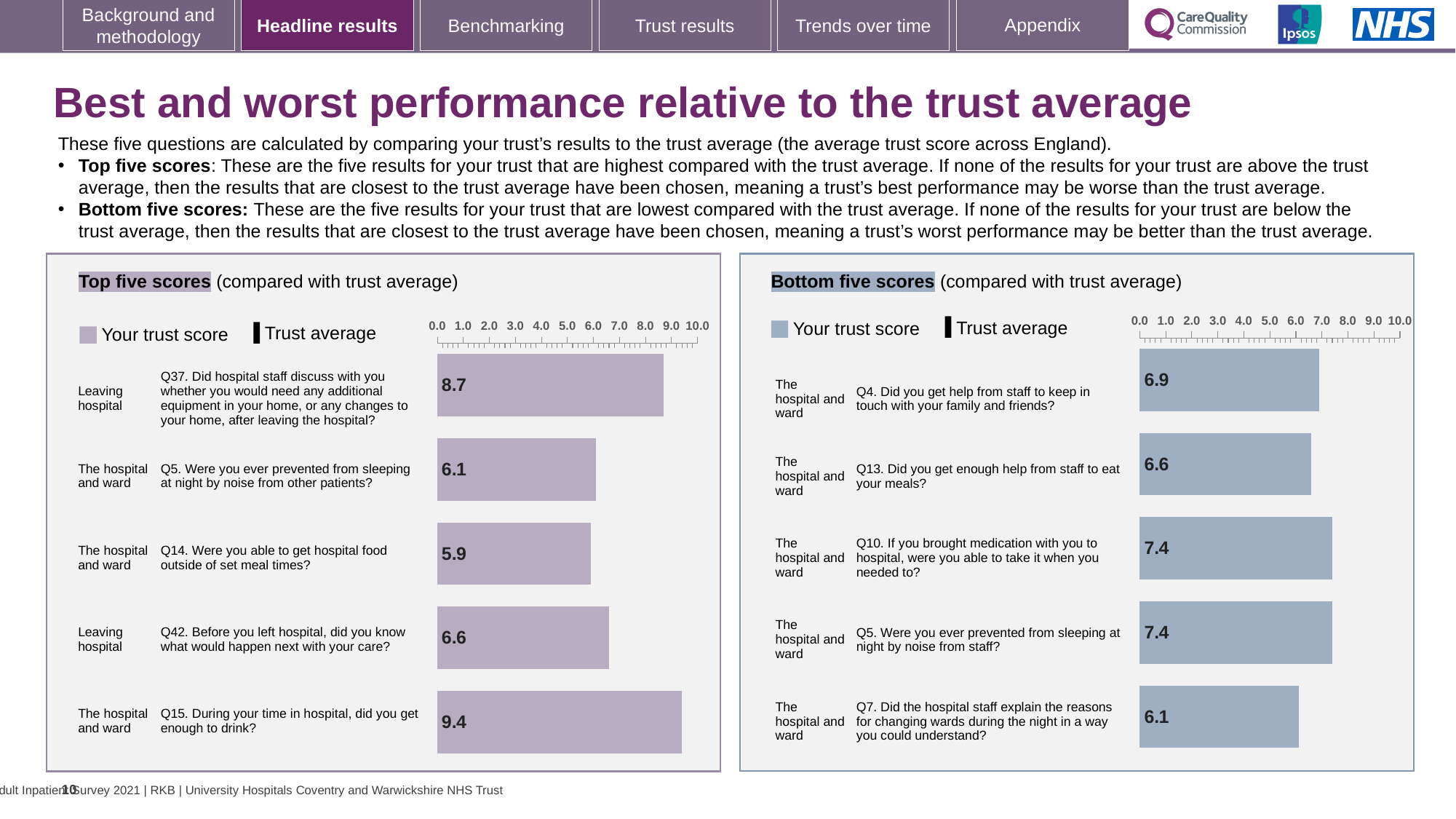
In the Top five scores chart, is the trust score for Q37 greater or less than 8.0? greater In the Top five scores chart, what is the trust score for Q42 (Before you left hospital, did you know what would happen next with your care?)? 6.6 In the Bottom five scores chart, which has the larger trust score, Q4 or Q13? Q4 What type of chart is used in the Top five scores panel? Bar chart In the Top five scores chart, which question has the lowest trust score? Q14 How many bars are shown in the Bottom five scores chart? 5 In the Bottom five scores chart, what is the difference between the trust scores for Q10 and Q7? 1.3 In the Top five scores chart, what is the trust score for Q15 (During your time in hospital, did you get enough to drink?)? 9.4 In the Bottom five scores chart, which question has the lowest trust score? Q7 In the Top five scores chart, which question has the highest trust score? Q15 In the Top five scores chart, what is the difference between the trust scores for Q15 and Q14? 3.5 In the Bottom five scores chart, what is the trust score for Q13 (Did you get enough help from staff to eat your meals?)? 6.6